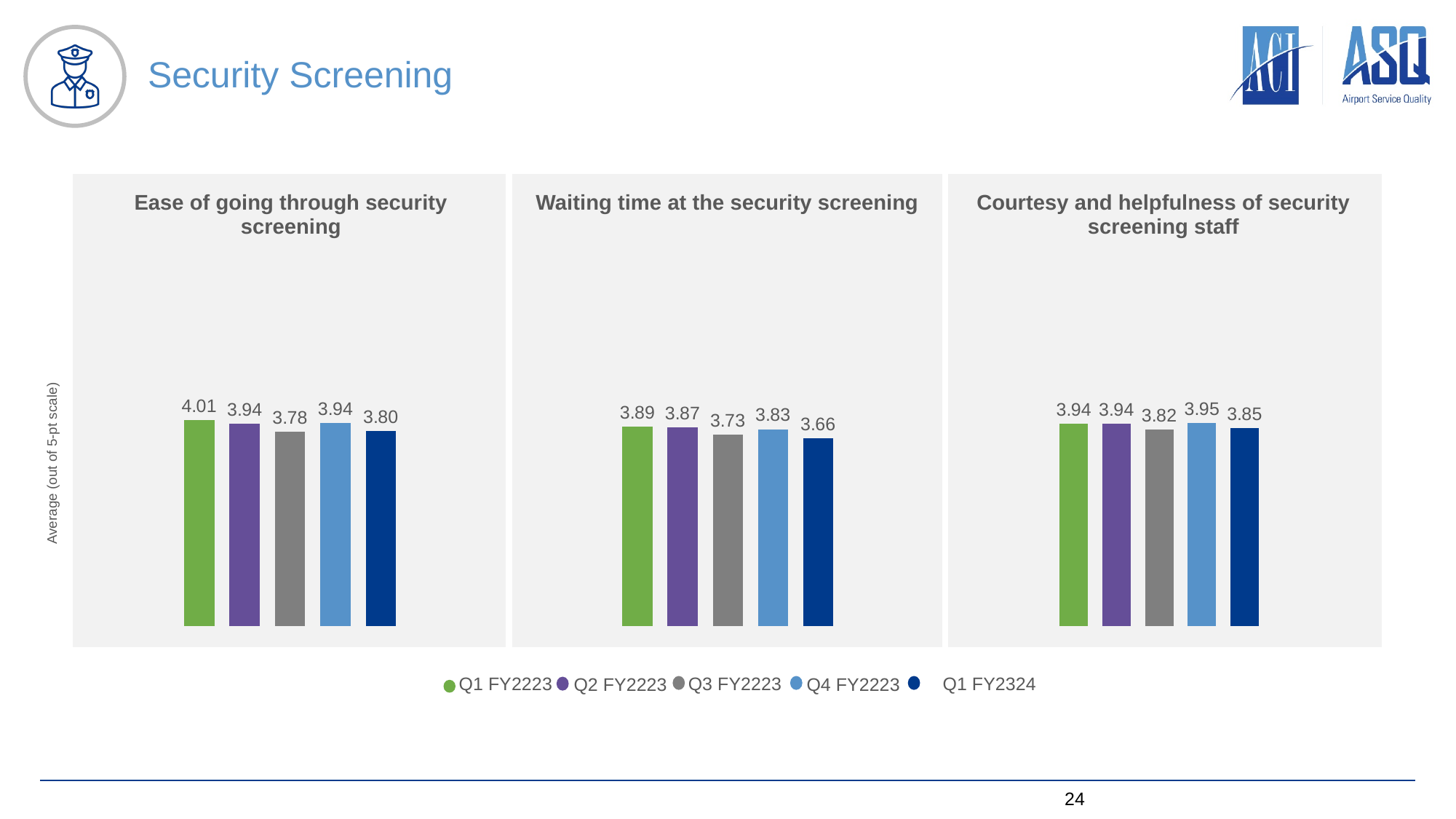
What kind of chart is the 'Courtesy and helpfulness of security screening staff' chart? Bar chart In the 'Waiting time at the security screening' chart, which quarter has the lowest value? Q1 FY2324 In the 'Courtesy and helpfulness of security screening staff' chart, which quarter has the highest value? Q4 FY2223 In the 'Waiting time at the security screening' chart, what is the difference between the Q4 FY2223 and Q1 FY2324 values? 0.17 In the 'Ease of going through security screening' chart, what is the difference between the Q1 FY2223 and Q1 FY2324 values? 0.21 What is the label on the vertical axis of the charts? Average (out of 5-pt scale) In the 'Waiting time at the security screening' chart, what is the value for Q1 FY2324? 3.66 In the 'Courtesy and helpfulness of security screening staff' chart, what is the value for Q3 FY2223? 3.82 In the 'Waiting time at the security screening' chart, which is larger: the value for Q1 FY2223 or Q3 FY2223? Q1 FY2223 In the 'Ease of going through security screening' chart, what is the value for Q1 FY2223? 4.01 How many series does the legend list? 5 In the 'Ease of going through security screening' chart, which quarter has the highest value? Q1 FY2223